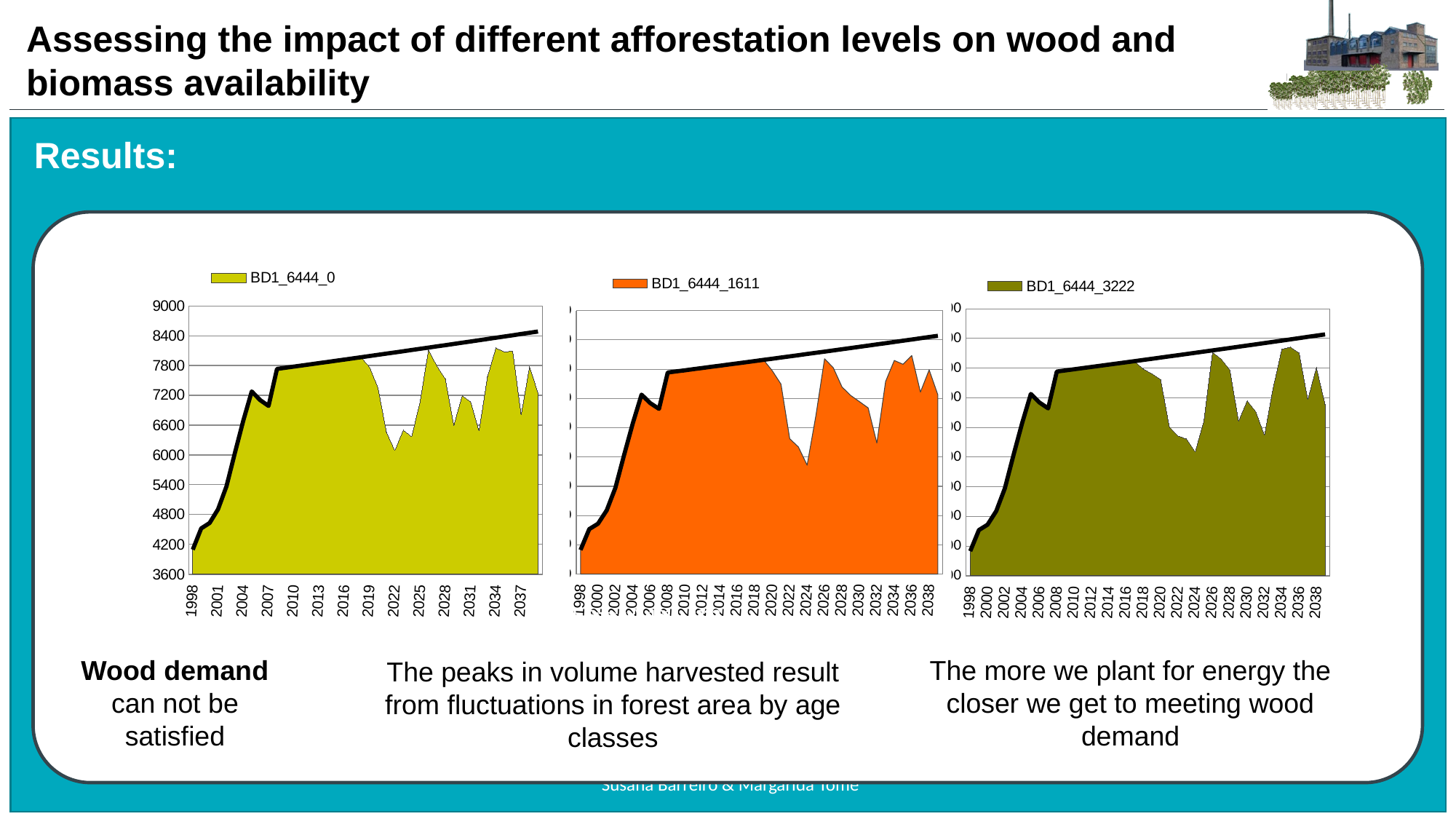
In the left chart (BD1_6444_0), is the shaded value for 2013 greater or less than 7200? greater What is the legend entry of the right chart? BD1_6444_3222 What is the legend entry of the middle chart? BD1_6444_1611 In the left chart (BD1_6444_0), does the shaded area rise or fall between 2019 and 2022? fall In the left chart (BD1_6444_0), which is larger, the shaded value for 2022 or the shaded value for 2034? 2034 What is the first year shown on the x axis of the left chart (BD1_6444_0)? 1998 What kind of chart is the left chart (BD1_6444_0)? combination area and line chart In the left chart (BD1_6444_0), does the black line rise or fall from 1998 to the end of the x axis? rise In the left chart (BD1_6444_0), is the shaded value for 2001 greater or less than 5400? less In the left chart (BD1_6444_0), is the shaded value for 2022 greater or less than 6600? less How many series does the legend of the left chart list? 1